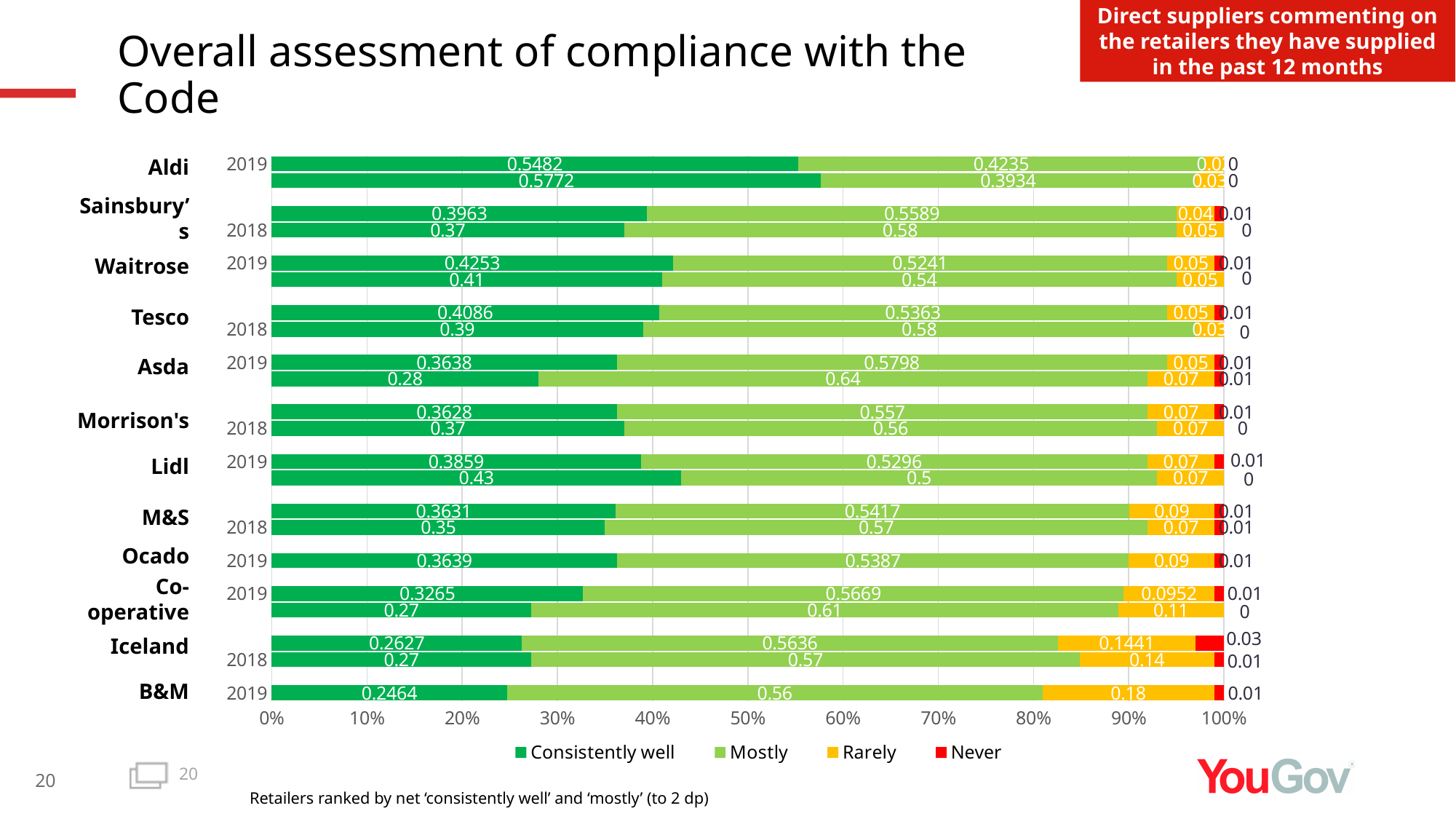
What is the 'Rarely' value for B&M in 2019? 0.18 How many retailers are shown on the chart? 12 What is the difference between Aldi's 'Consistently well' value in 2018 and in 2019? 0.029 What is the 'Never' value for Iceland in 2019? 0.03 Which retailer has the lowest 'Consistently well' value in 2019? B&M Which colour represents the 'Never' series in the legend? Red What is the 'Consistently well' value for Aldi in 2019? 0.5482 How many series does the legend list? 4 Which retailer has the highest 'Consistently well' value in 2019? Aldi What kind of chart is shown on the slide? Stacked bar chart What is the 'Mostly' value for Asda in 2018? 0.64 Which is larger: Lidl's 'Consistently well' value in 2019 or in 2018? 2018